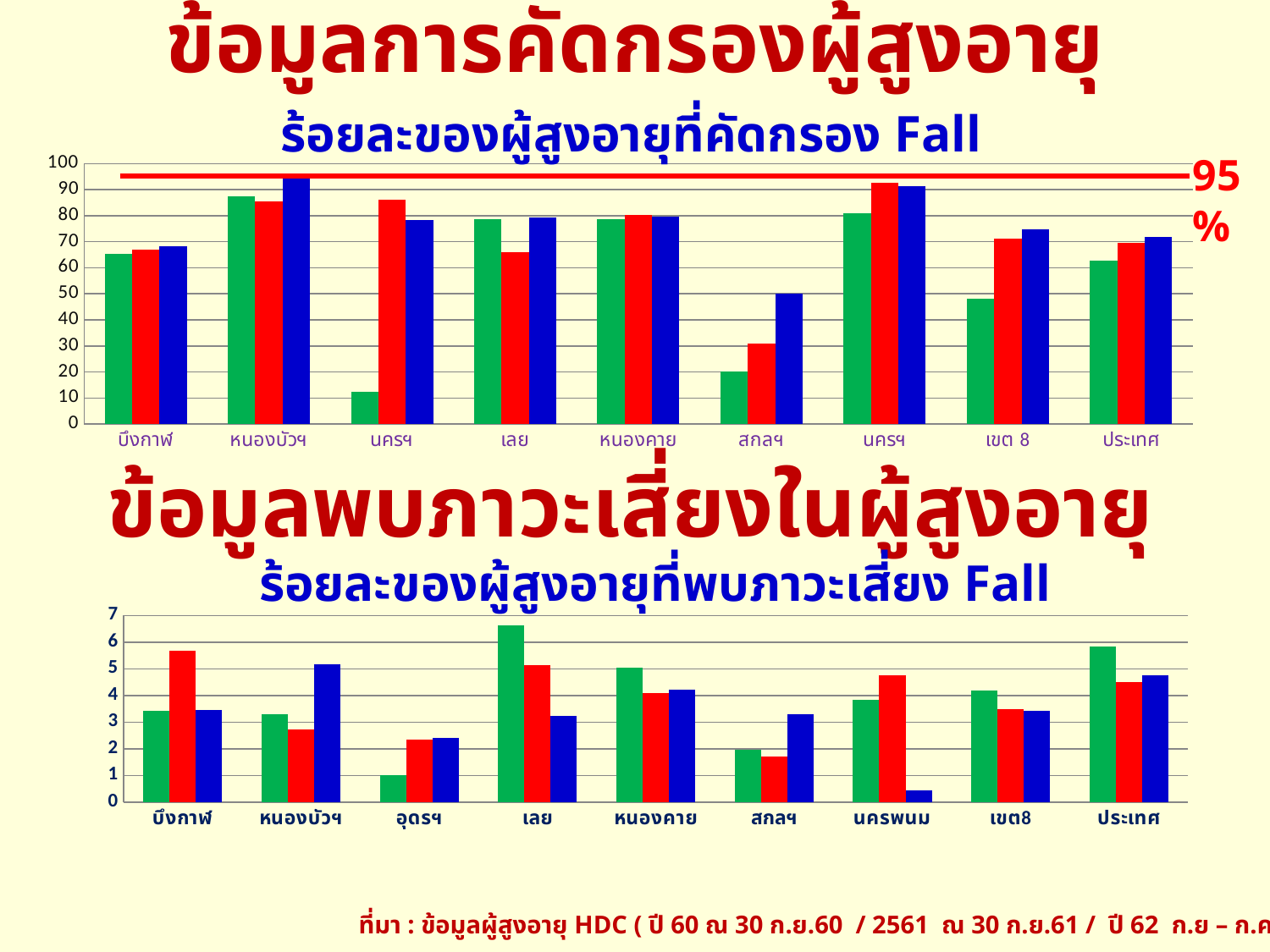
How many categories are shown on the x axis of the top chart, 'ร้อยละของผู้สูงอายุที่คัดกรอง Fall'? 9 What kind of chart is the bottom chart, 'ร้อยละของผู้สูงอายุที่พบภาวะเสี่ยง Fall'? bar chart In the bottom chart, 'ร้อยละของผู้สูงอายุที่พบภาวะเสี่ยง Fall', which category has the highest green bar? เลย What kind of chart is the top chart, 'ร้อยละของผู้สูงอายุที่คัดกรอง Fall'? bar chart In the top chart, 'ร้อยละของผู้สูงอายุที่คัดกรอง Fall', which category has the lowest blue bar? สกลฯ In the top chart, 'ร้อยละของผู้สูงอายุที่คัดกรอง Fall', is the red bar for สกลฯ greater or less than 20? greater What value does the red horizontal reference line in the top chart mark? 95 % In the bottom chart, 'ร้อยละของผู้สูงอายุที่พบภาวะเสี่ยง Fall', which category has the lowest blue bar? นครพนม In the top chart, 'ร้อยละของผู้สูงอายุที่คัดกรอง Fall', is the blue bar for หนองบัวฯ greater or less than 90? greater In the bottom chart, 'ร้อยละของผู้สูงอายุที่พบภาวะเสี่ยง Fall', which is larger for บึงกาฬ, the green bar or the red bar? the red bar In the bottom chart, 'ร้อยละของผู้สูงอายุที่พบภาวะเสี่ยง Fall', is the red bar for บึงกาฬ greater or less than 5? greater How many categories are shown on the x axis of the bottom chart, 'ร้อยละของผู้สูงอายุที่พบภาวะเสี่ยง Fall'? 9